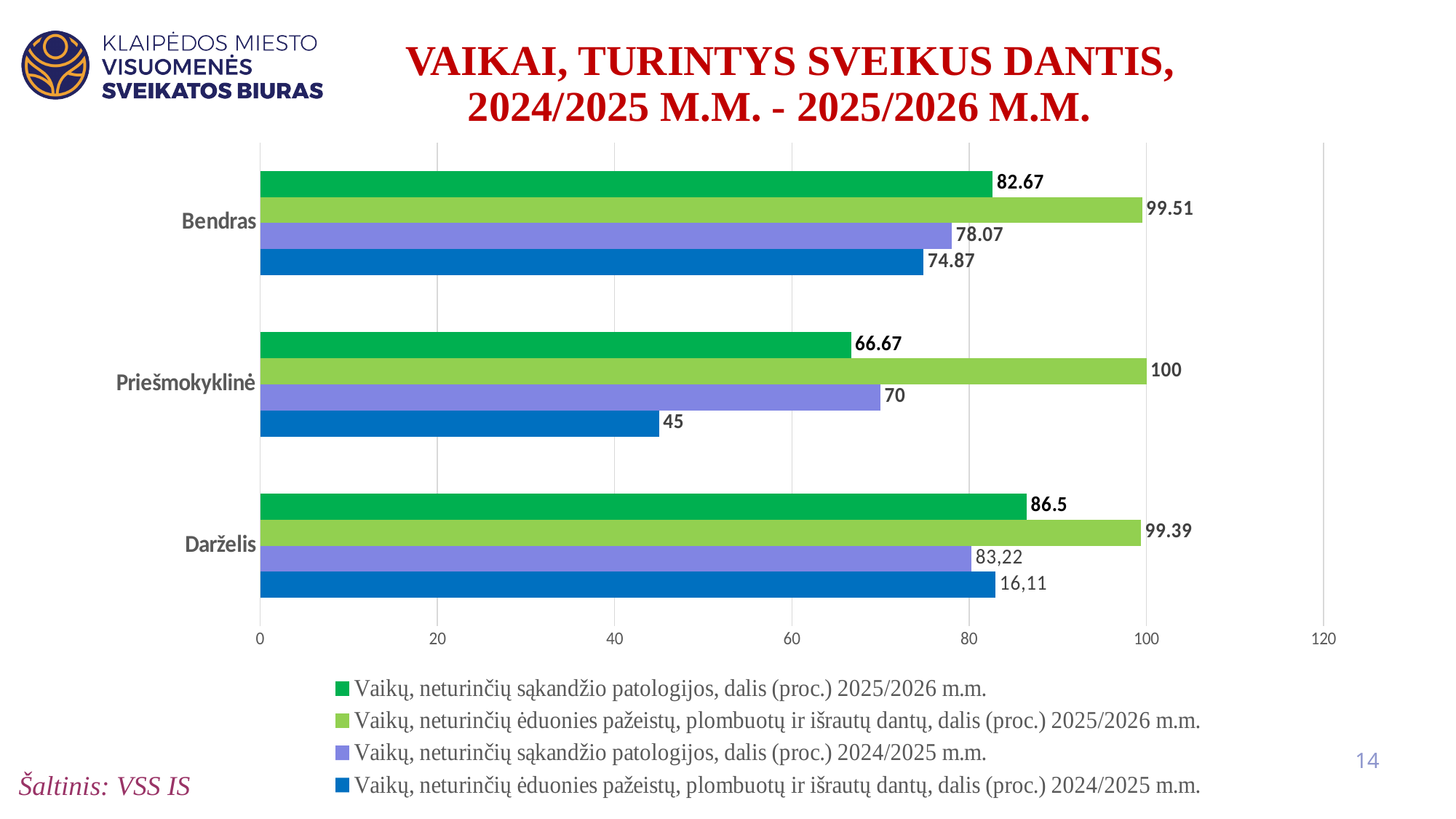
What is the value for Darželis in the series 'Vaikų, neturinčių sąkandžio patologijos, dalis (proc.) 2024/2025 m.m.'? 83,22 What is the value for Priešmokyklinė in the series 'Vaikų, neturinčių ėduonies pažeistų, plombuotų ir išrautų dantų, dalis (proc.) 2025/2026 m.m.'? 100 Which category has the lowest value in the series 'Vaikų, neturinčių sąkandžio patologijos, dalis (proc.) 2025/2026 m.m.'? Priešmokyklinė How many categories are shown on the vertical axis of the chart? 3 Which category has the highest value in the series 'Vaikų, neturinčių sąkandžio patologijos, dalis (proc.) 2025/2026 m.m.'? Darželis What is the value for Bendras in the series 'Vaikų, neturinčių sąkandžio patologijos, dalis (proc.) 2025/2026 m.m.'? 82.67 For Priešmokyklinė, what is the difference between the 2024/2025 value for children without occlusion pathology (70) and the 2024/2025 value for children without caries-affected, filled or extracted teeth (45)? 25 Is the value for Priešmokyklinė in the series 'Vaikų, neturinčių sąkandžio patologijos, dalis (proc.) 2024/2025 m.m.' greater or less than 60? greater How many series does the legend list? 4 What is the value for Priešmokyklinė in the series 'Vaikų, neturinčių ėduonies pažeistų, plombuotų ir išrautų dantų, dalis (proc.) 2024/2025 m.m.'? 45 For Bendras, which 2024/2025 series has the larger value: children without occlusion pathology or children without caries-affected, filled or extracted teeth? Children without occlusion pathology (78.07) For Bendras, what is the difference between the 2025/2026 value for children without caries-affected, filled or extracted teeth (99.51) and the 2025/2026 value for children without occlusion pathology (82.67)? 16.84